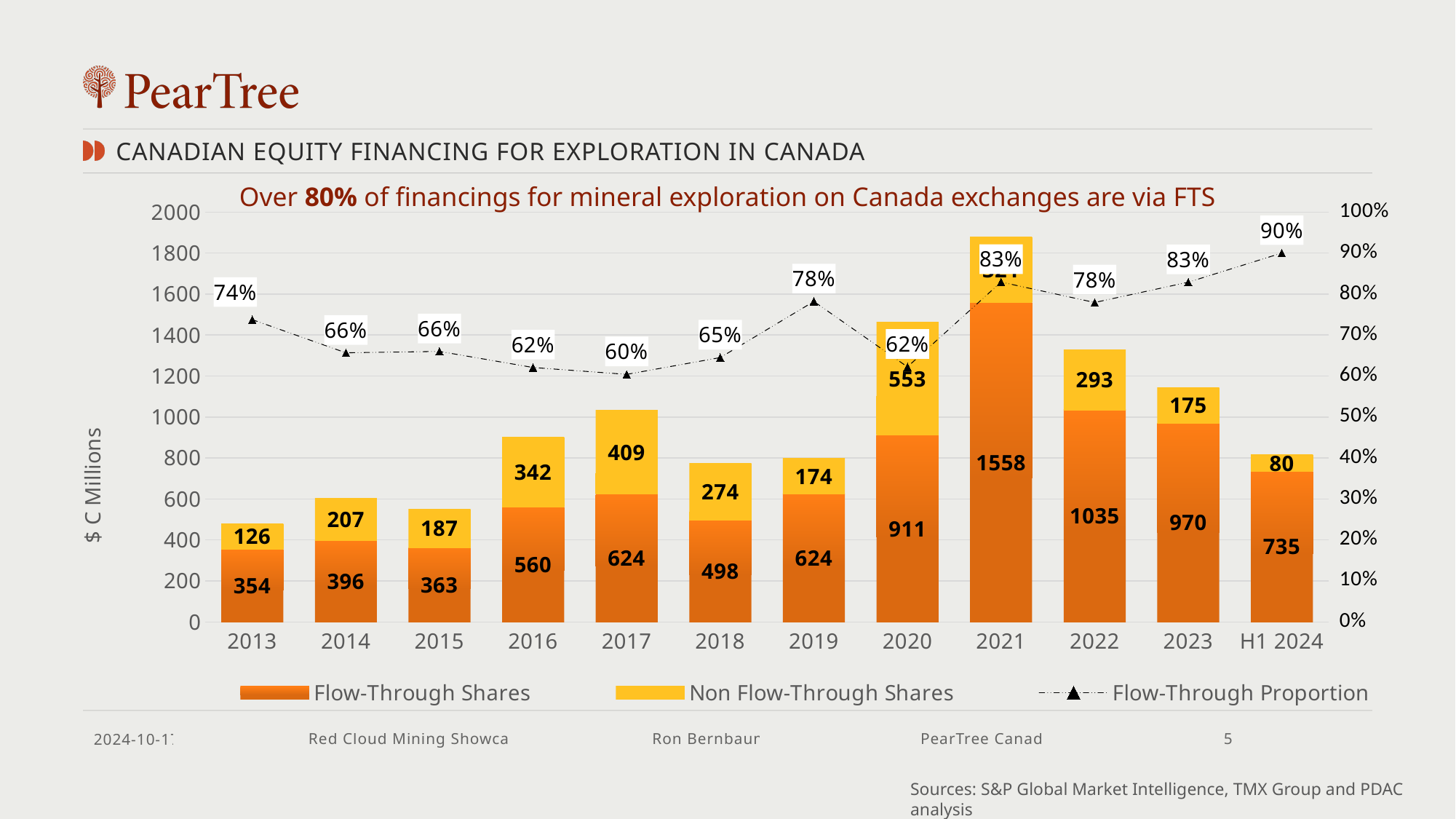
Is the total height of the 2021 bar greater or less than 1800? greater How many series does the legend list? 3 What is the Flow-Through Proportion for H1 2024? 90% How many periods are shown on the x axis? 12 What kind of chart is used to show the Flow-Through and Non Flow-Through Shares values? Stacked bar chart What is the value of Non Flow-Through Shares for 2020? 553 What is the total of the stacked bar for 2013? 480 Which is larger, the Non Flow-Through Shares value for 2016 or for 2017? 2017 Which year has the lowest Flow-Through Proportion? 2017 Which year has the highest value for Flow-Through Shares? 2021 What is the difference between the Flow-Through Shares values for 2022 and 2023? 65 What is the value of Flow-Through Shares for 2021? 1558